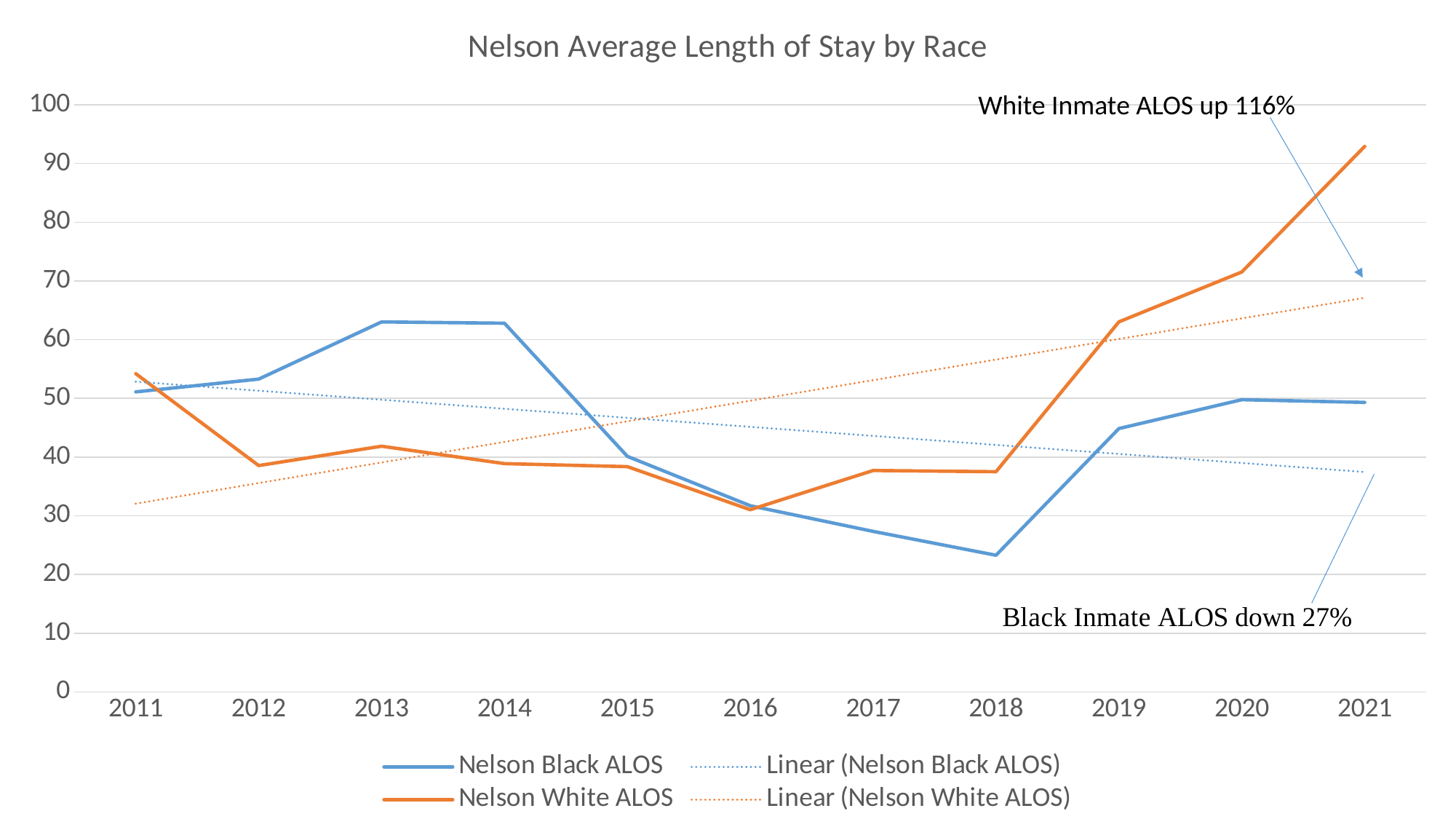
Is the Nelson Black ALOS value for 2018 greater or less than 30? less What is the title of the chart? Nelson Average Length of Stay by Race Is the Nelson Black ALOS value for 2013 greater or less than 60? greater Is the Nelson White ALOS value for 2021 greater or less than 90? greater How many years are shown on the x axis? 11 In which year is the Nelson Black ALOS lowest? 2018 How many entries does the legend list? 4 What kind of chart is shown on the slide? line chart In 2021, which is larger: Nelson Black ALOS or Nelson White ALOS? Nelson White ALOS Does the Nelson White ALOS rise or fall from 2018 to 2021? rise In which year is the Nelson White ALOS lowest? 2016 In which year is the Nelson White ALOS highest? 2021